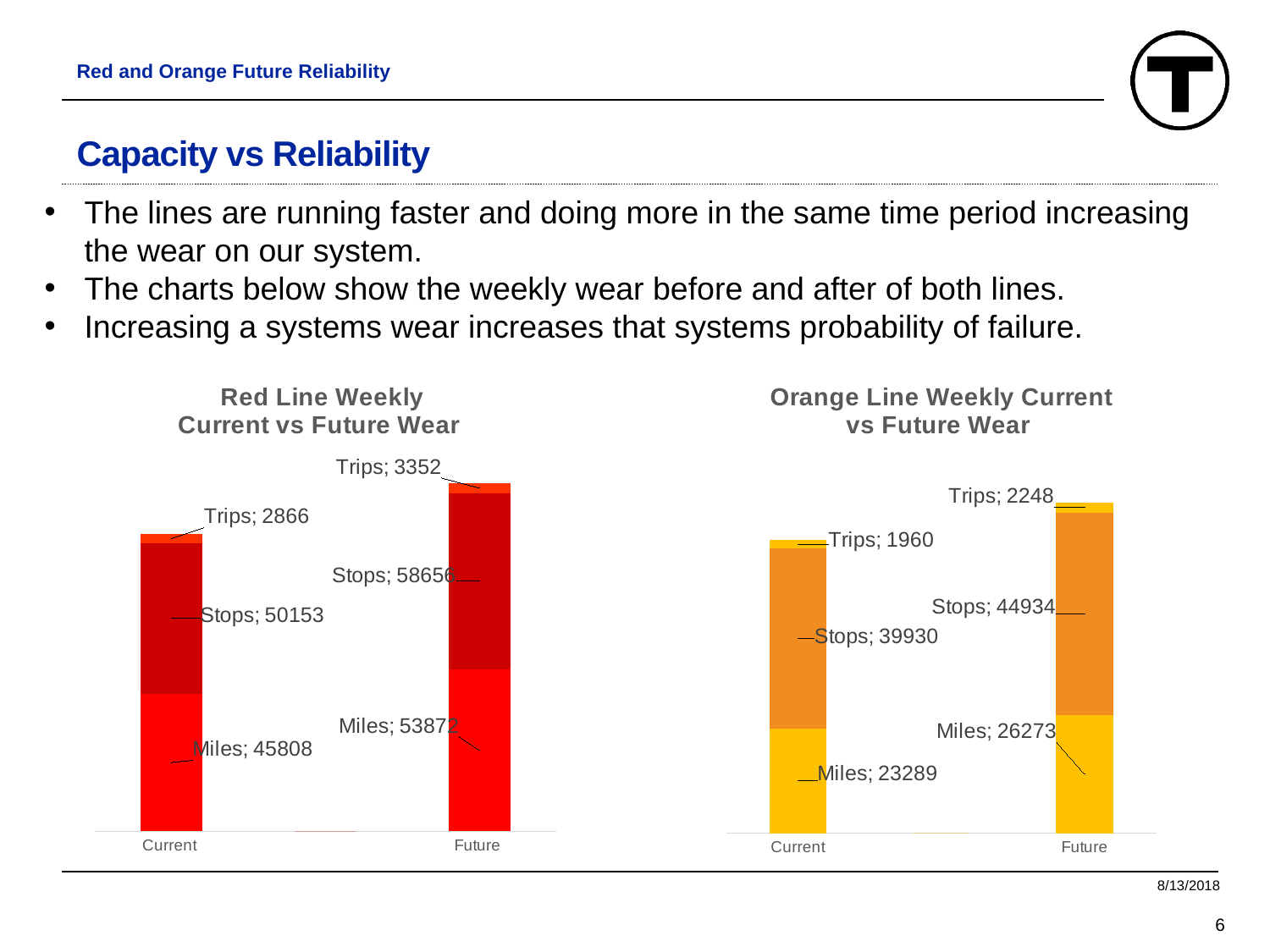
In the Red Line Weekly Current vs Future Wear chart, by how much do Stops increase from Current to Future? 8503 In the Orange Line Weekly Current vs Future Wear chart, what is the difference in Miles between Future and Current? 2984 In the Red Line Weekly Current vs Future Wear chart, what is the Miles value for Current? 45808 In the Orange Line Weekly Current vs Future Wear chart, what is the total of the Current stacked bar? 65179 In the Red Line Weekly Current vs Future Wear chart, which is larger, Trips for Current or Trips for Future? Future What type of chart is the Red Line Weekly Current vs Future Wear chart? Stacked bar chart In the Red Line Weekly Current vs Future Wear chart, what is the total of the Future stacked bar? 115880 In the Orange Line Weekly Current vs Future Wear chart, which category has the taller stacked bar? Future In the Red Line Weekly Current vs Future Wear chart, what is the Stops value for Future? 58656 How many categories are shown on the x axis of the Orange Line Weekly Current vs Future Wear chart? 2 In the Orange Line Weekly Current vs Future Wear chart, what is the Miles value for Future? 26273 In the Orange Line Weekly Current vs Future Wear chart, what is the Trips value for Current? 1960